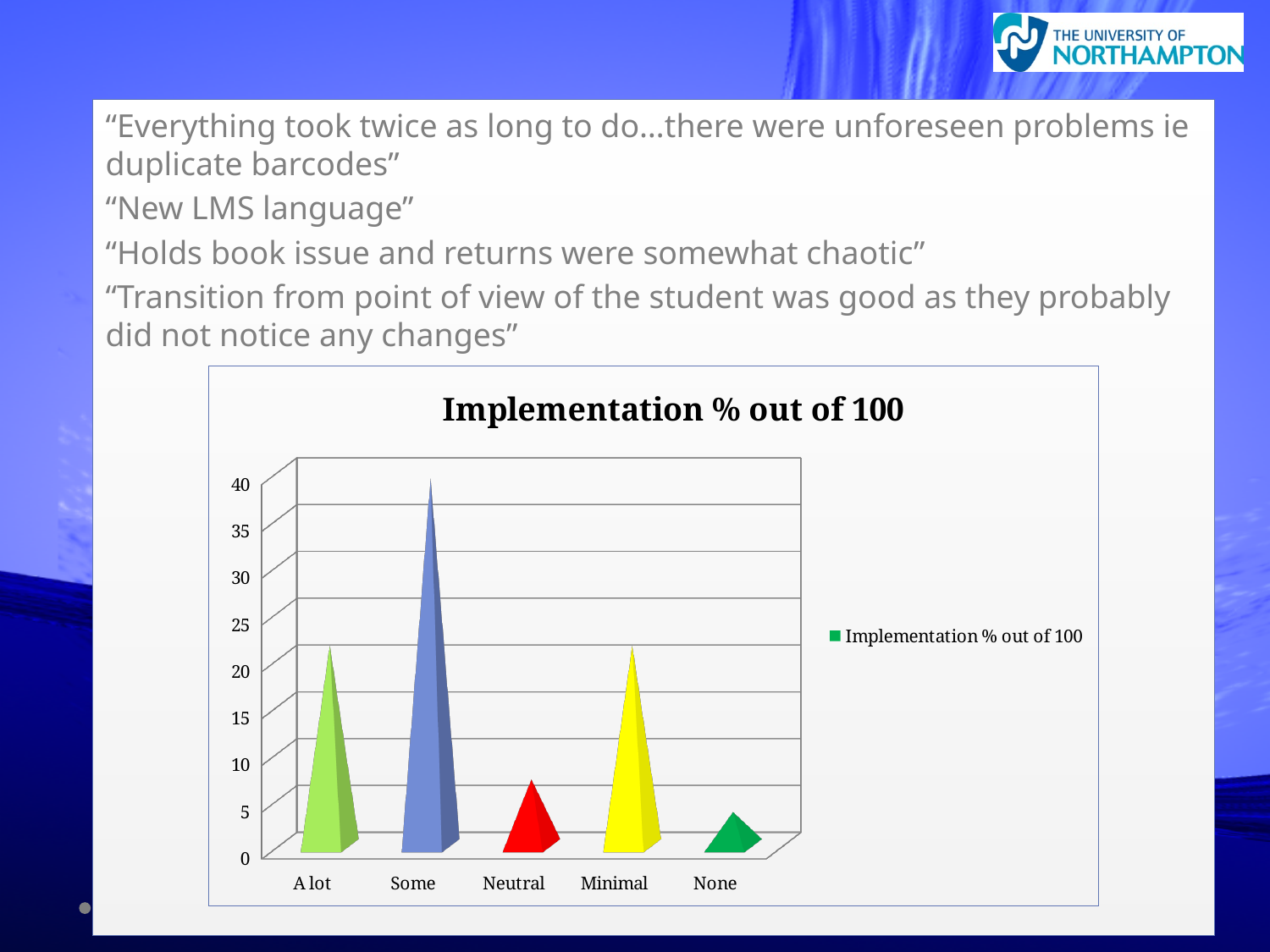
What is the title of the chart? Implementation % out of 100 What colour is the bar for the Neutral category? red What type of chart is shown on the slide? bar chart Is the value for Some greater or less than 30? greater Which category has the lowest value in the chart? None Is the value for Neutral greater or less than 10? less Is the value for None greater or less than 10? less Which category has the highest value in the chart? Some How many categories are shown on the x axis of the chart? 5 How many series does the chart legend list? 1 Which is larger, the value for Some or the value for Neutral? Some